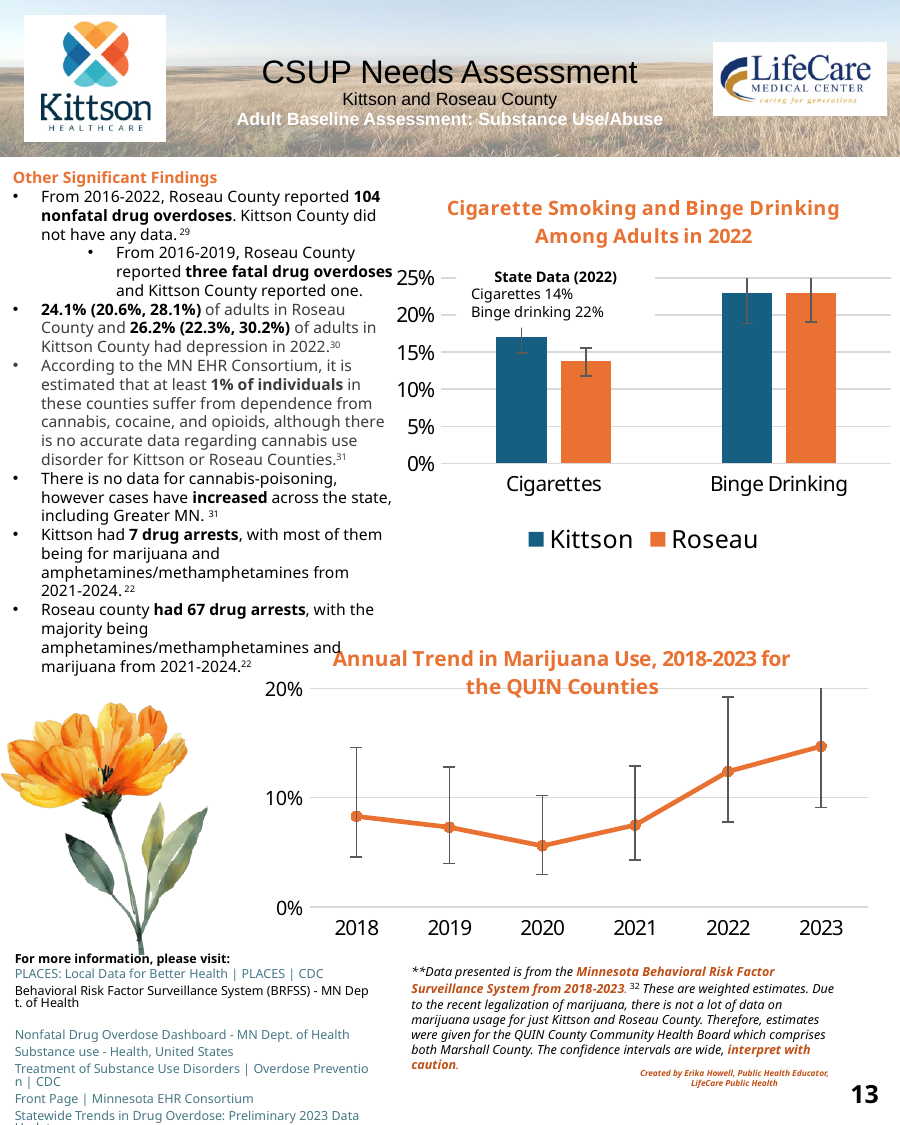
In the 'Cigarette Smoking and Binge Drinking Among Adults in 2022' chart, which two series are shown in the legend? Kittson and Roseau In the 'Cigarette Smoking and Binge Drinking Among Adults in 2022' chart, what kind of chart is used? Bar chart In the 'Cigarette Smoking and Binge Drinking Among Adults in 2022' chart, which county has the higher value for Cigarettes, Kittson or Roseau? Kittson In the 'Annual Trend in Marijuana Use, 2018-2023 for the QUIN Counties' chart, which year has the highest value? 2023 In the 'Annual Trend in Marijuana Use, 2018-2023 for the QUIN Counties' chart, how many years are plotted? 6 In the 'Cigarette Smoking and Binge Drinking Among Adults in 2022' chart, is the Kittson value for Binge Drinking greater or less than 20%? greater In the 'Annual Trend in Marijuana Use, 2018-2023 for the QUIN Counties' chart, which year has the lowest value? 2020 In the 'Annual Trend in Marijuana Use, 2018-2023 for the QUIN Counties' chart, what kind of chart is used? Line chart In the 'Cigarette Smoking and Binge Drinking Among Adults in 2022' chart, is the Kittson value for Cigarettes greater or less than 15%? greater In the 'Annual Trend in Marijuana Use, 2018-2023 for the QUIN Counties' chart, do the values rise or fall from 2020 to 2023? Rise In the 'Cigarette Smoking and Binge Drinking Among Adults in 2022' chart, how many series does the legend list? 2 In the 'Cigarette Smoking and Binge Drinking Among Adults in 2022' chart, how many categories are shown on the x axis? 2